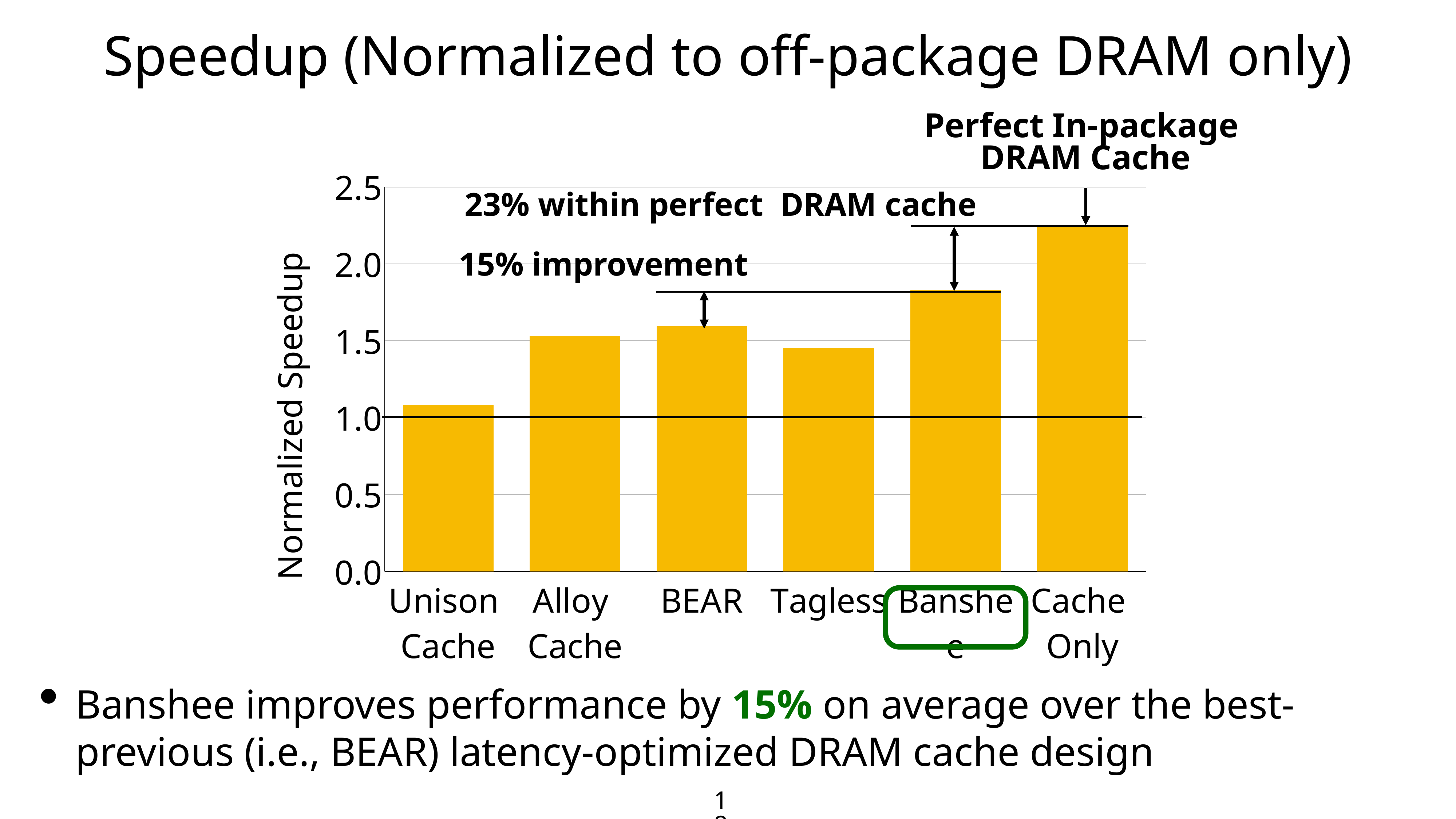
How many categories (bars) are plotted in the chart? 6 Which has a higher normalized speedup, Unison Cache or Alloy Cache? Alloy Cache Which category has the highest normalized speedup? Cache Only Which has a higher normalized speedup, Banshee or BEAR? Banshee Is the normalized speedup for Banshee greater or less than 2.0? less Is the normalized speedup for BEAR greater or less than 1.5? greater Is the normalized speedup for Tagless greater or less than 1.5? less What is the label of the y axis of the chart? Normalized Speedup According to the annotation on the chart, by what percentage does Banshee improve over BEAR? 15% What kind of chart is shown on the slide? bar chart Which category has the lowest normalized speedup? Unison Cache